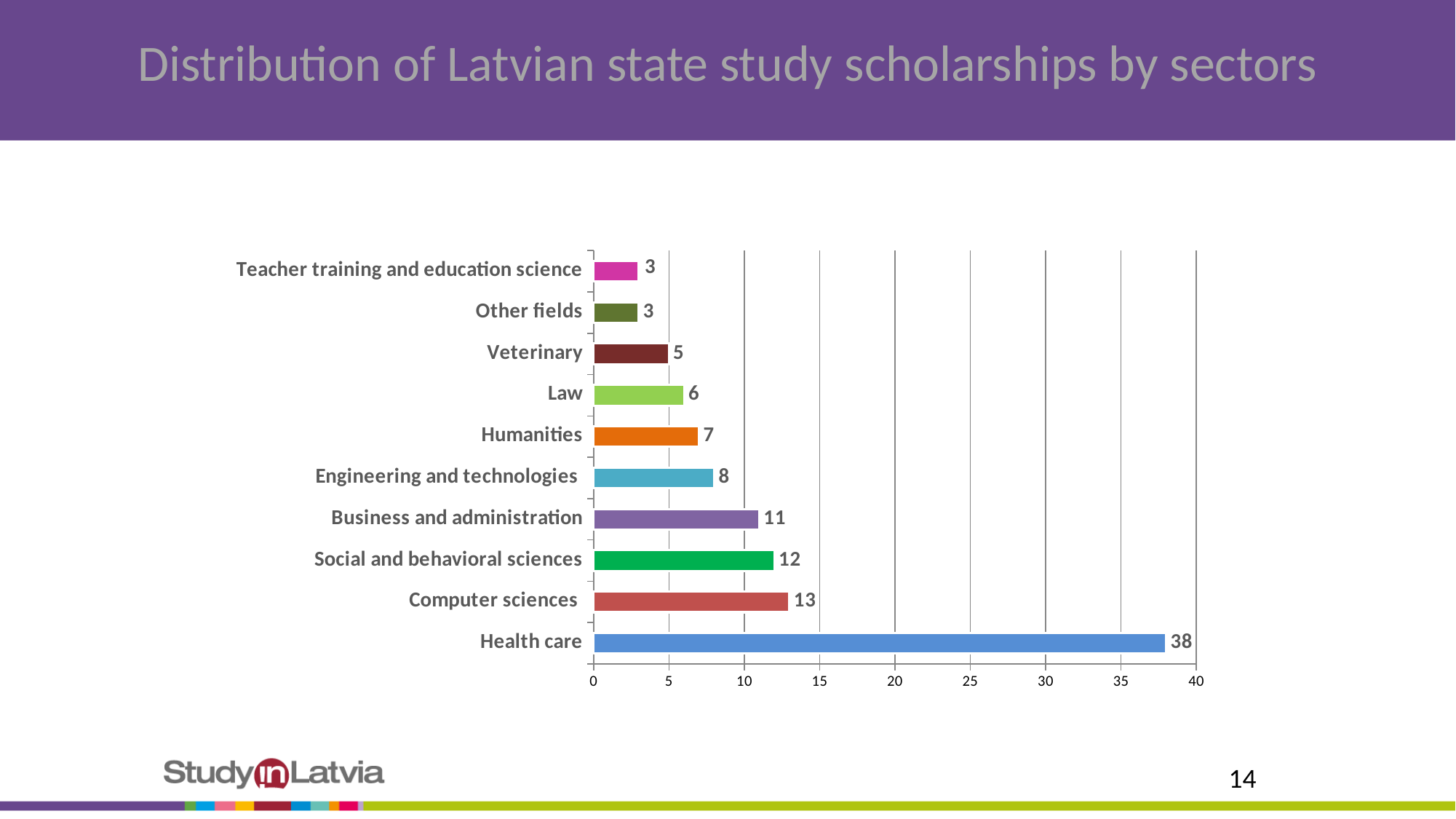
Which is larger, Social and behavioral sciences or Humanities? Social and behavioral sciences How many sectors are shown in the chart? 10 How many scholarships does the chart show for Health care? 38 What is the difference between Business and administration and Law? 5 What kind of chart is shown on the slide? Bar chart Which sector has the lowest value, other than the two tied at 3? Veterinary Which sector has the highest value? Health care What is the difference between Health care and Computer sciences? 25 What is the value for Computer sciences? 13 Is the value for Health care greater or less than 35? greater What is the value for Engineering and technologies? 8 What is the title of the slide? Distribution of Latvian state study scholarships by sectors